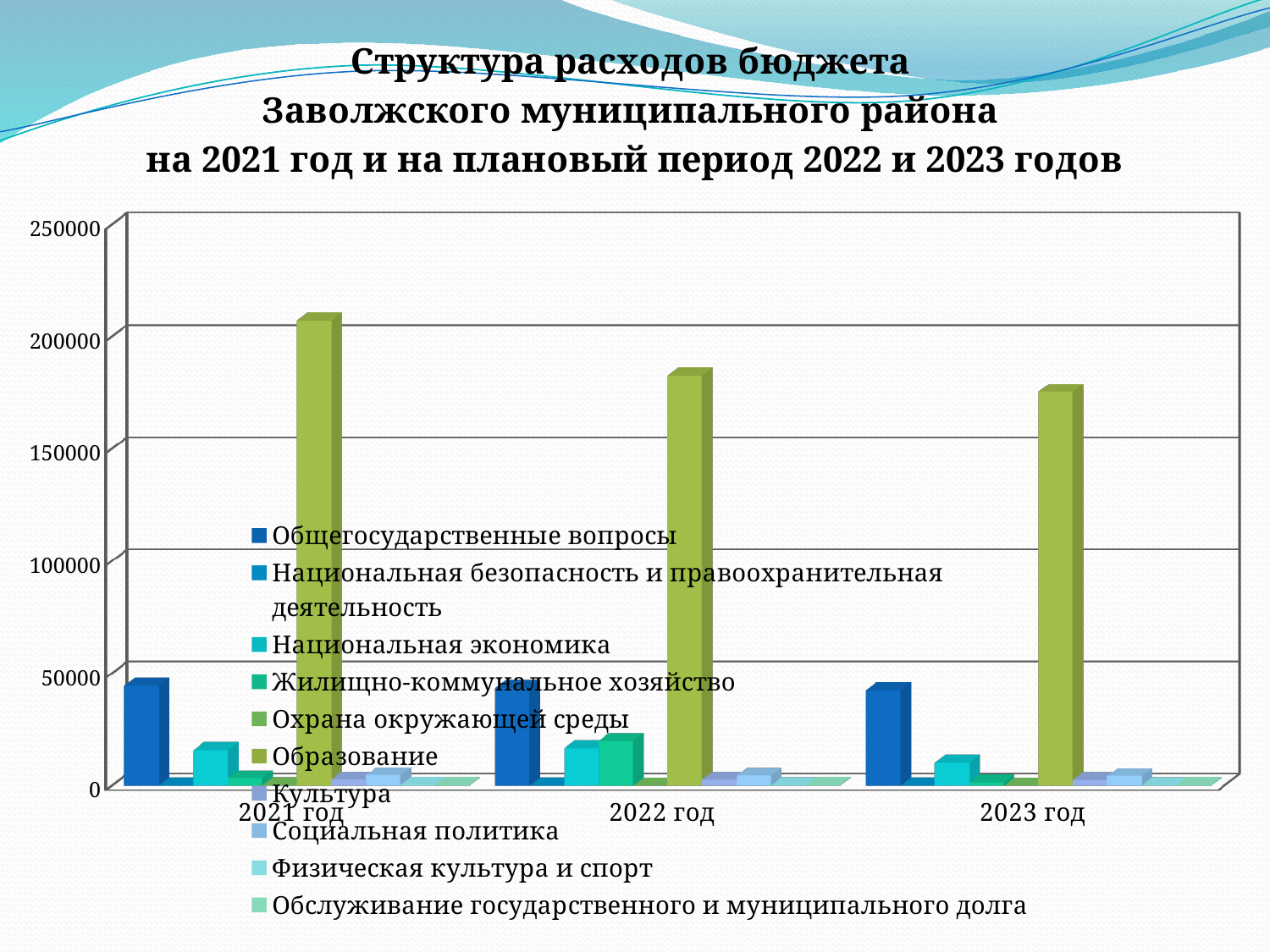
Does the value for Образование rise or fall from 2021 год to 2023 год? fall How many series does the legend list? 10 Which is larger in 2021 год: Образование or Общегосударственные вопросы? Образование Is the value for Образование in 2021 год greater or less than 150000? greater Is the value for Общегосударственные вопросы in 2021 год greater or less than 100000? less What kind of chart is shown on the slide? bar chart What is the first line of the slide title? Структура расходов бюджета How many year categories are shown on the x axis? 3 Is the value for Образование in 2022 год greater or less than 200000? less Which series is listed last in the legend? Обслуживание государственного и муниципального долга In which year is the bar for Образование the highest? 2021 год Which series has the tallest bar in 2022 год? Образование